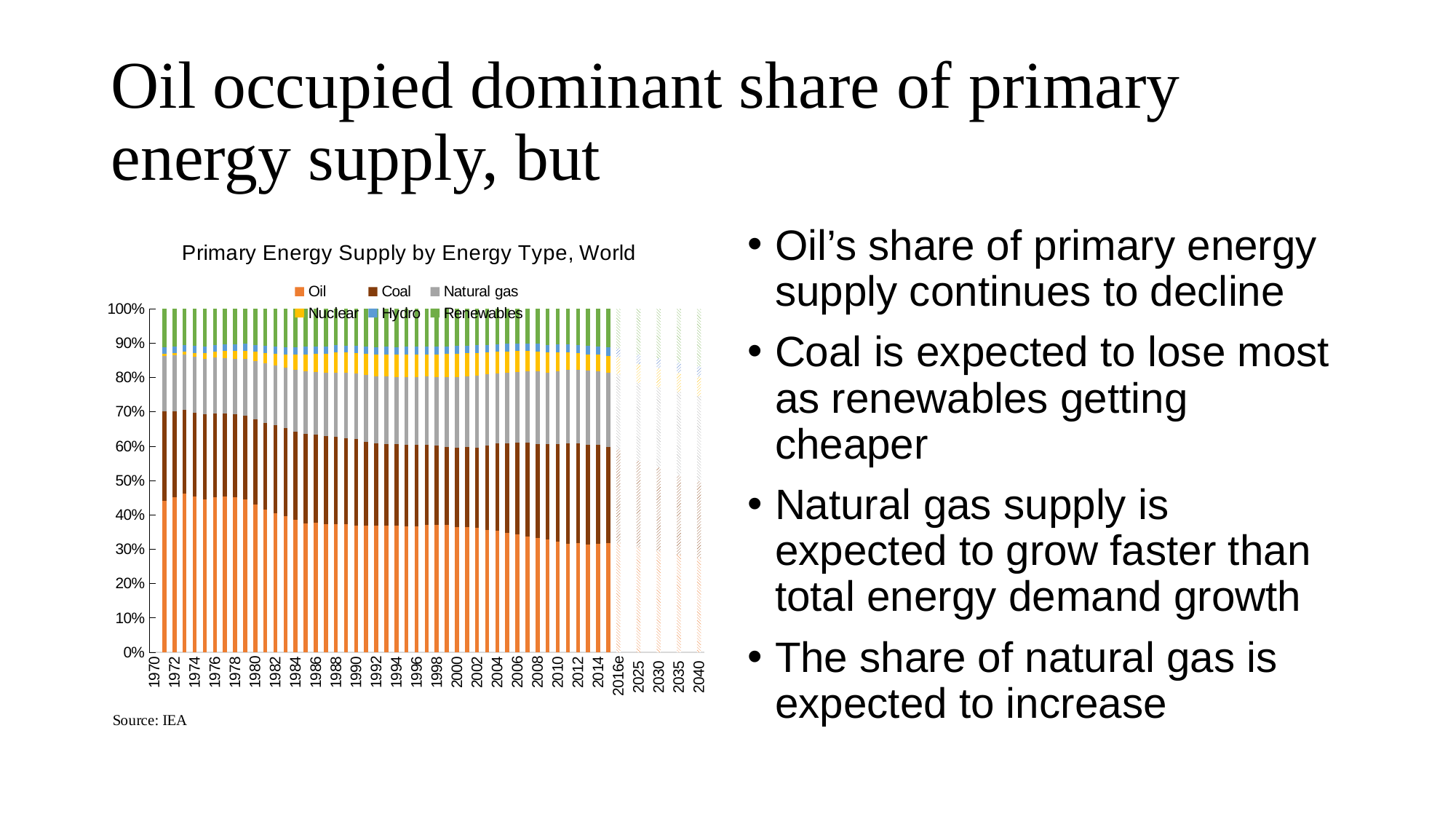
What is the source cited for the chart? IEA Is the Oil share in 1970 greater or less than 40%? greater Which energy type has the largest share in 1970? Oil What is the title of the chart? Primary Energy Supply by Energy Type, World Which series is shown in orange in the chart's legend? Oil In 1970, which has the larger share, Oil or Coal? Oil Is the Oil share in 1990 greater or less than 50%? less What kind of chart is shown on the slide? Stacked bar chart What is the total of the stacked bar for 1970? 100% Is the Oil share in 2014 greater or less than 40%? less Does Oil's share of primary energy supply rise or fall from 1970 to 2014? Fall How many series does the legend of the chart list? 6